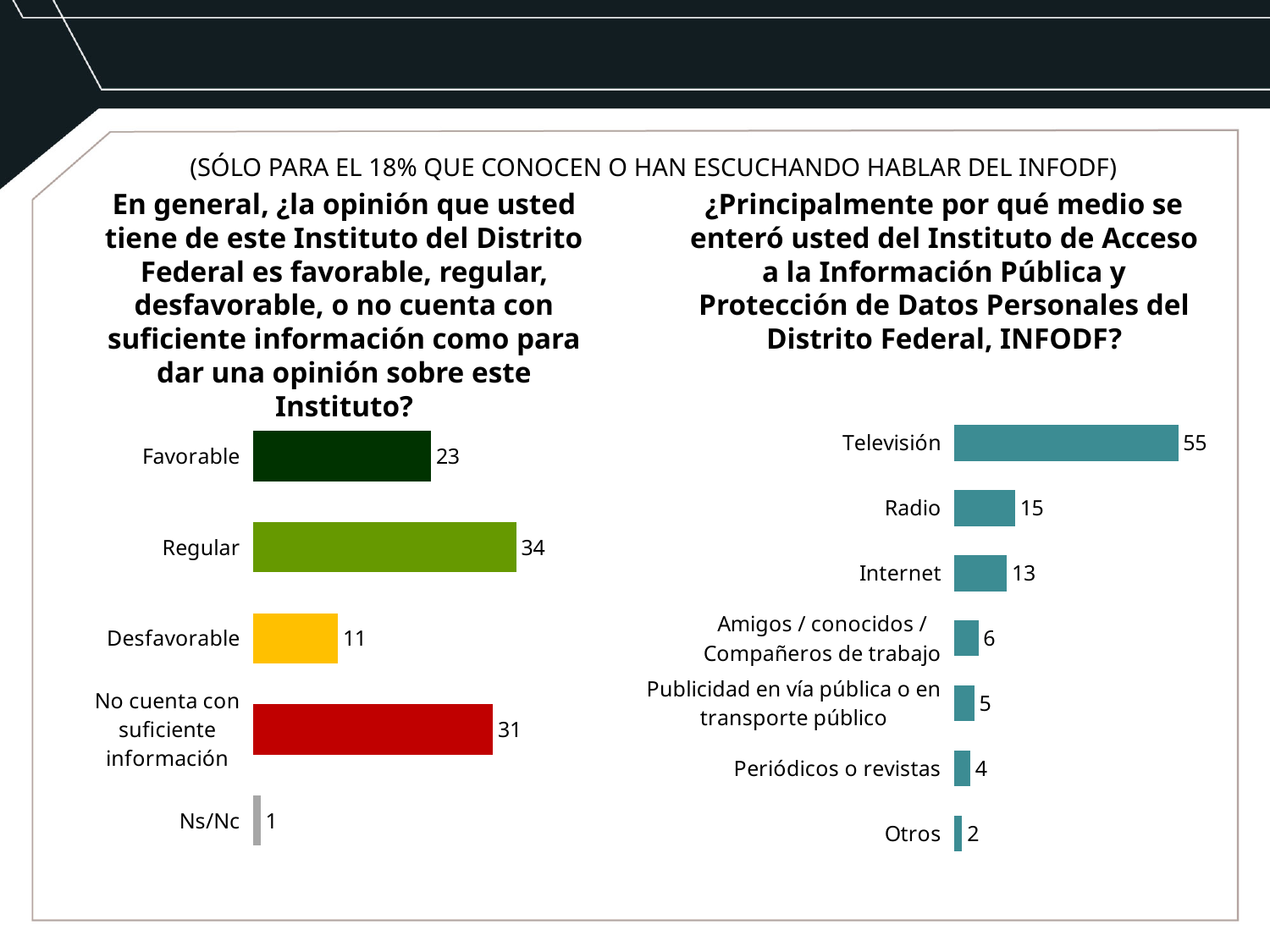
In the right chart (medio por el que se enteró del INFODF), what is the value for Internet? 13 In the left chart (opinion of the Instituto del Distrito Federal), which category has the highest value? Regular In the left chart (opinion of the Instituto del Distrito Federal), what is the difference between the values for Regular and Favorable? 11 In the right chart (medio por el que se enteró del INFODF), which is larger, Radio or Internet? Radio In the right chart (medio por el que se enteró del INFODF), how many categories are shown? 7 In the right chart (medio por el que se enteró del INFODF), what is the difference between Televisión and Radio? 40 In the left chart (opinion of the Instituto del Distrito Federal), what is the value for Regular? 34 What type of chart is the right chart (medio por el que se enteró del INFODF)? Bar chart In the left chart (opinion of the Instituto del Distrito Federal), how many categories are shown? 5 In the left chart (opinion of the Instituto del Distrito Federal), which category has the lowest value? Ns/Nc In the right chart (medio por el que se enteró del INFODF), which category has the lowest value? Otros In the right chart (medio por el que se enteró del INFODF), what is the value for Televisión? 55